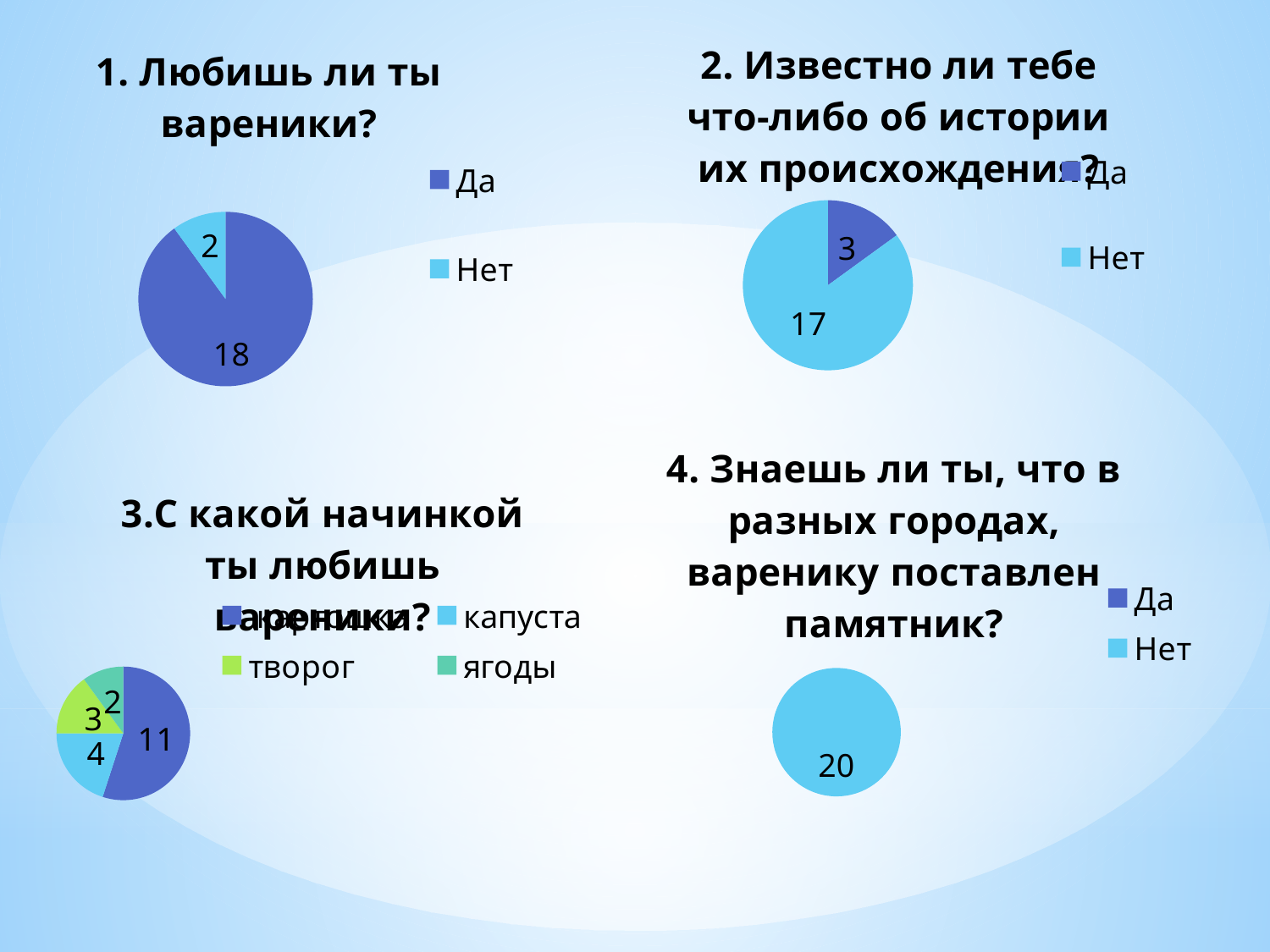
In the chart titled "3.С какой начинкой ты любишь вареники?", what is the value for капуста? 4 In the chart titled "2. Известно ли тебе что-либо об истории их происхождения?", which category is the largest? Нет In the chart titled "2. Известно ли тебе что-либо об истории их происхождения?", what is the value for Нет? 17 In the chart titled "1. Любишь ли ты вареники?", what is the value for Да? 18 In the chart titled "1. Любишь ли ты вареники?", what is the value for Нет? 2 In the chart titled "3.С какой начинкой ты любишь вареники?", what is the value for творог? 3 In the chart titled "4. Знаешь ли ты, что в разных городах, варенику поставлен памятник?", what is the value for Нет? 20 In the chart titled "3.С какой начинкой ты любишь вареники?", how many categories does the legend list? 4 In the chart titled "2. Известно ли тебе что-либо об истории их происхождения?", what share of the pie does Да represent? 15% What type of chart is used for "1. Любишь ли ты вареники?"? Pie chart In the chart titled "1. Любишь ли ты вареники?", what is the difference between the Да and Нет values? 16 In the chart titled "3.С какой начинкой ты любишь вареники?", which category is the smallest? ягоды